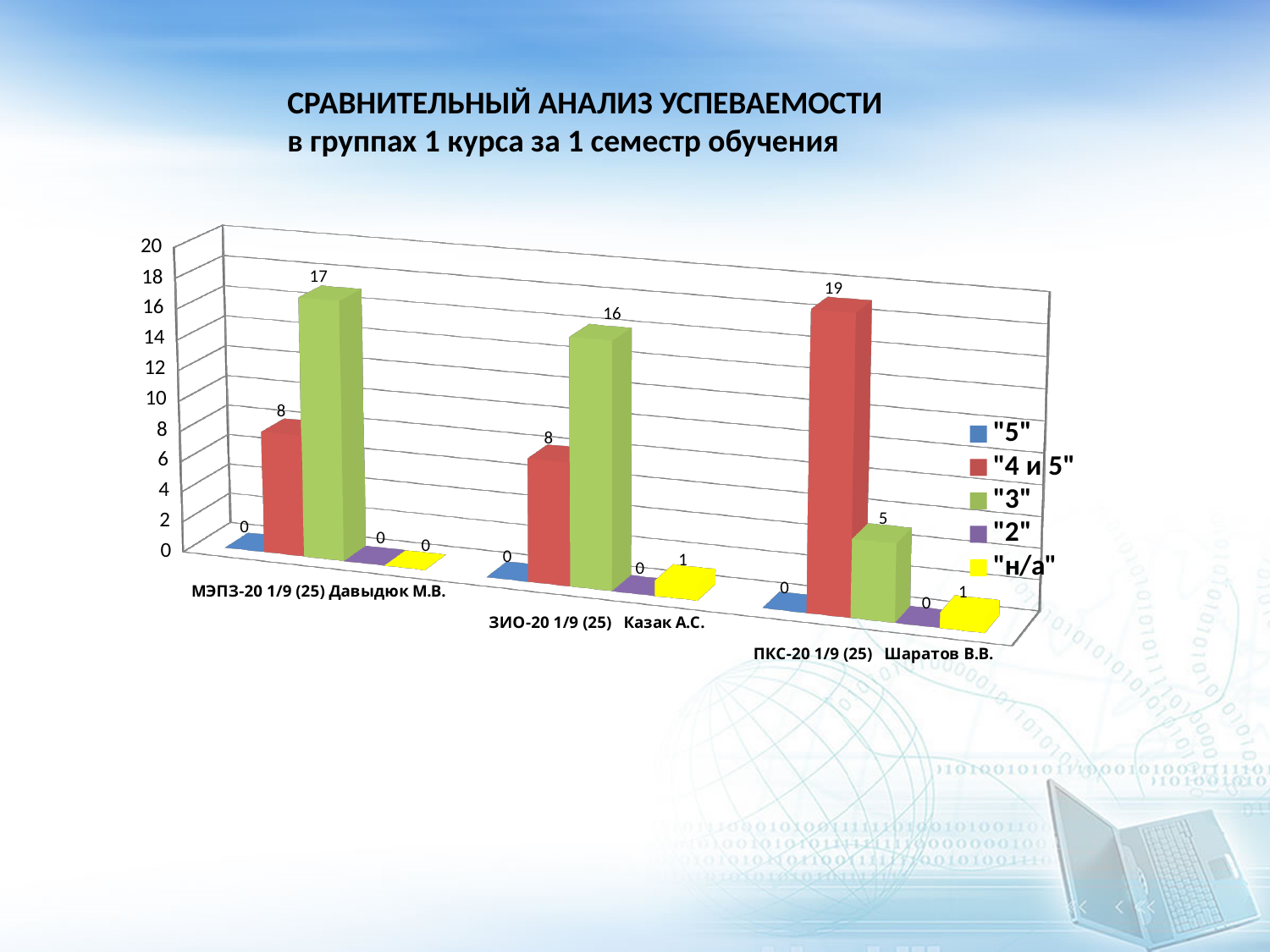
What colour are the bars for the "н/а" series? Yellow How many series does the legend list? 5 Which group has the highest value for "4 и 5"? ПКС-20 1/9 (25) Шаратов В.В. What is the value of "4 и 5" for the group ПКС-20 1/9 (25) Шаратов В.В.? 19 Which group has the lowest value for "3"? ПКС-20 1/9 (25) Шаратов В.В. What is the value of "3" for the group МЭПЗ-20 1/9 (25) Давыдюк М.В.? 17 What is the difference between the "4 и 5" and "3" values for ПКС-20 1/9 (25) Шаратов В.В.? 14 For the group ЗИО-20 1/9 (25) Казак А.С., which is larger: "4 и 5" or "3"? "3" What is the difference between the "3" values for МЭПЗ-20 1/9 (25) Давыдюк М.В. and ЗИО-20 1/9 (25) Казак А.С.? 1 How many groups are shown on the x axis? 3 What is the value of "н/а" for the group ЗИО-20 1/9 (25) Казак А.С.? 1 What kind of chart is shown on the slide? Bar chart